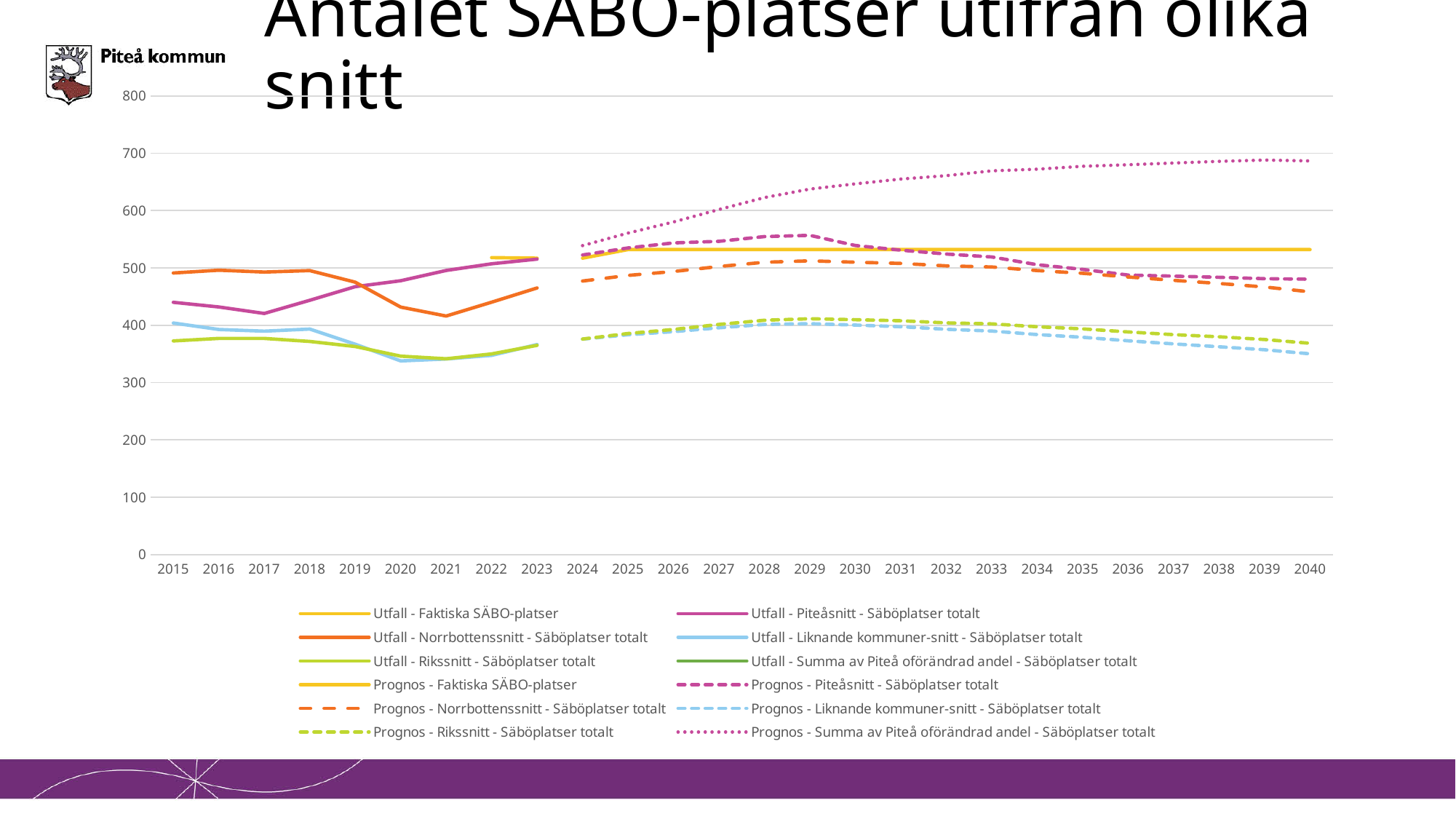
In 2015, which is larger: 'Utfall - Norrbottenssnitt - Säböplatser totalt' or 'Utfall - Rikssnitt - Säböplatser totalt'? Utfall - Norrbottenssnitt - Säböplatser totalt Which series has the lowest value in 2040? Prognos - Liknande kommuner-snitt - Säböplatser totalt Is the value for 'Prognos - Summa av Piteå oförändrad andel - Säböplatser totalt' in 2040 greater or less than 600? greater Does the 'Prognos - Summa av Piteå oförändrad andel - Säböplatser totalt' line rise or fall from 2024 to 2040? rise Is the value for 'Prognos - Faktiska SÄBO-platser' in 2030 greater or less than 500? greater Is the value for 'Utfall - Liknande kommuner-snitt - Säböplatser totalt' in 2020 greater or less than 400? less Which series has the highest value in 2040? Prognos - Summa av Piteå oförändrad andel - Säböplatser totalt How many years are shown on the x axis? 26 How many series does the legend list? 12 What kind of chart is shown on the slide? line chart What is the title of the chart? Antalet SÄBO-platser utifrån olika snitt